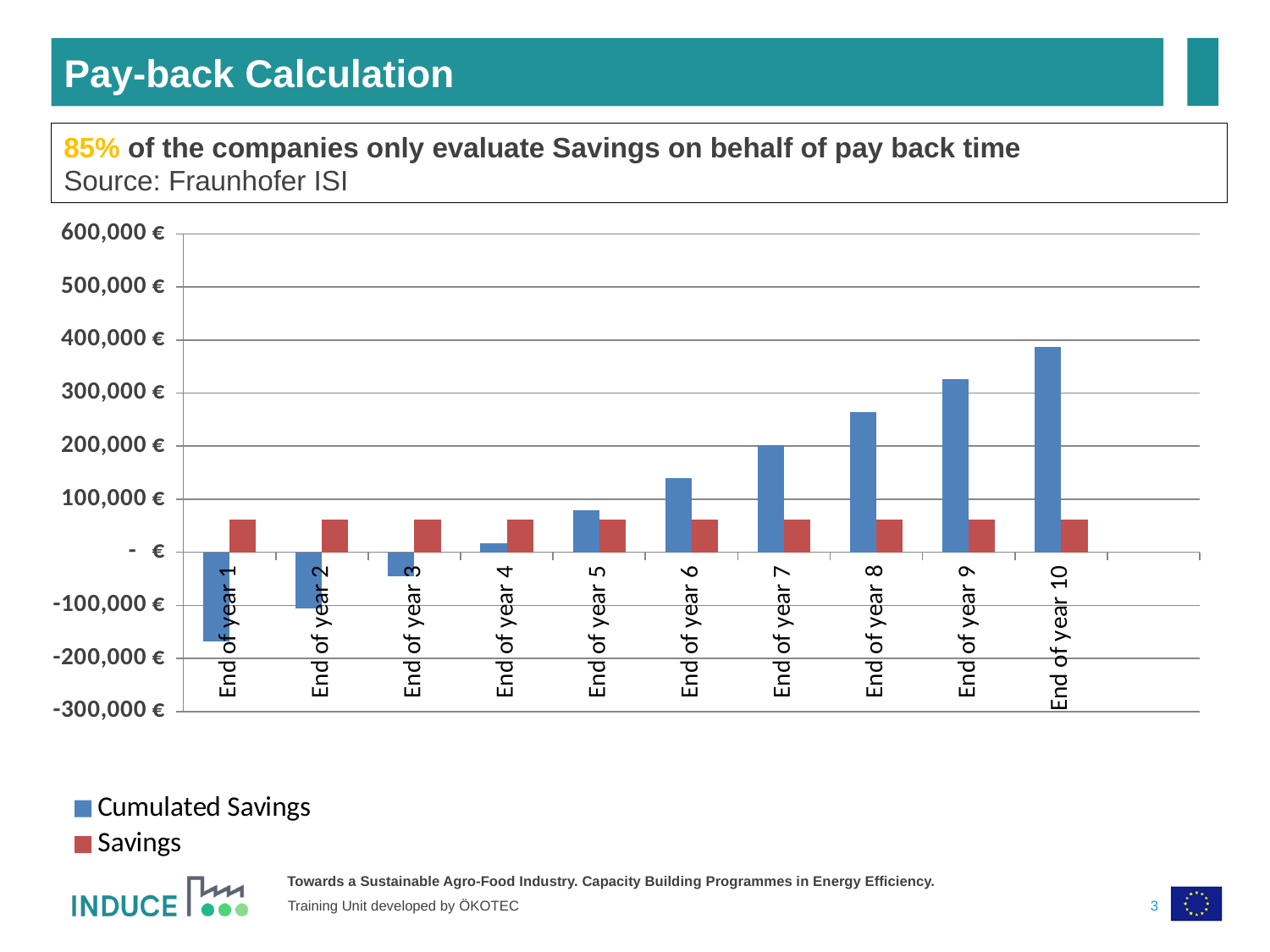
Which has the larger Cumulated Savings value, End of year 6 or End of year 8? End of year 8 How many series does the legend list? 2 Is the Cumulated Savings value for End of year 10 greater or less than 300,000 €? greater What colour are the Savings bars? Red Which category has the highest Cumulated Savings value? End of year 10 Is the Cumulated Savings value for End of year 1 greater or less than -100,000 €? less How many categories are shown on the x axis? 10 What kind of chart is shown on the slide? Bar chart Do the Cumulated Savings values rise or fall from End of year 1 to End of year 10? Rise Which category has the lowest Cumulated Savings value? End of year 1 Is the Savings value for End of year 5 greater or less than 100,000 €? less Which series is shown in blue? Cumulated Savings